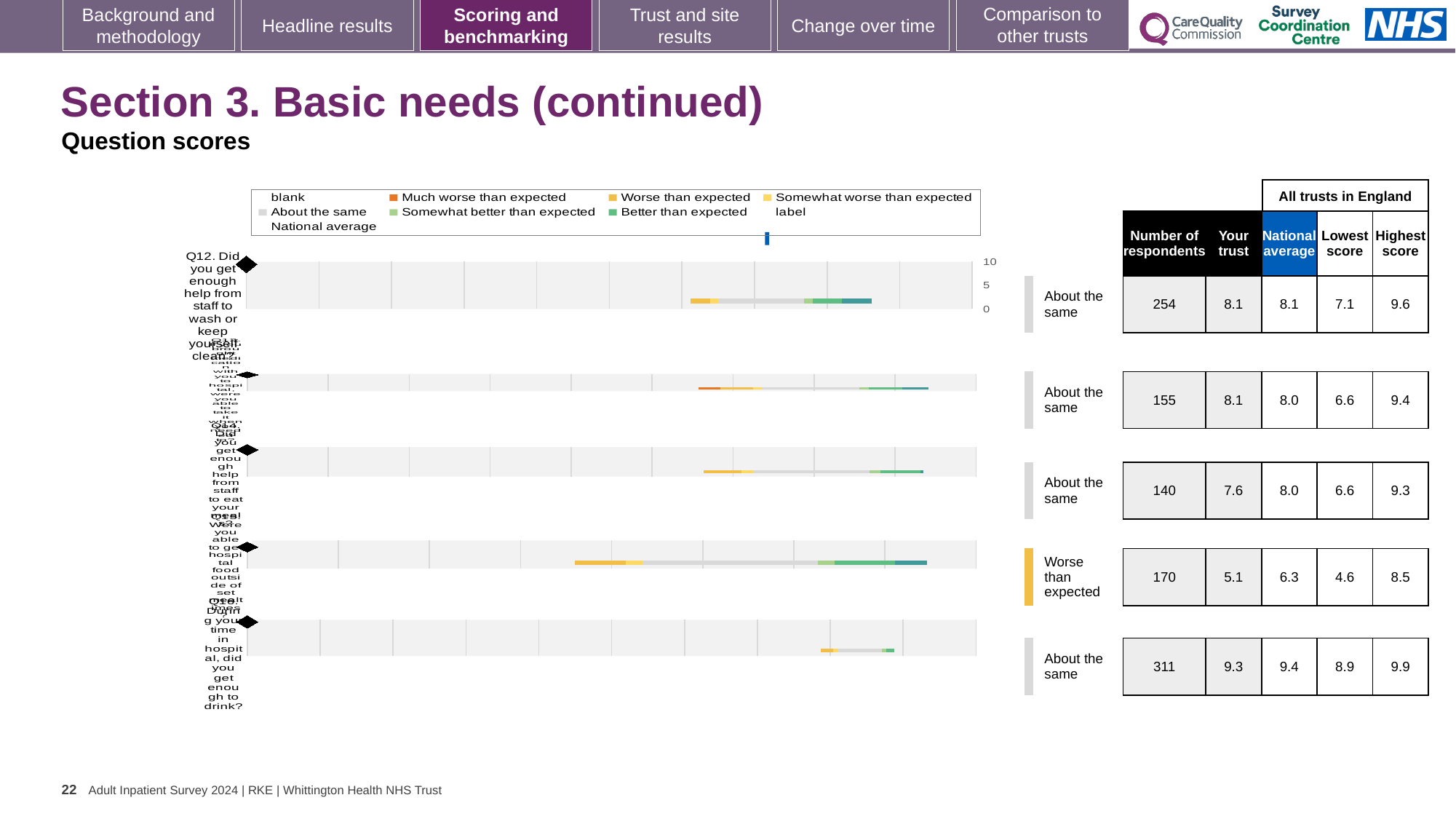
According to the table beside the chart, what is the 'Your trust' score for the first row (Q12, help from staff to wash or keep yourself clean)? 8.1 How many question rows are plotted in the chart? 5 What is the national average for the fourth row, the one rated 'Worse than expected'? 6.3 Which row has the highest 'Your trust' score? the fifth row (Q16, enough to drink), 9.3 Which row has the lowest 'Your trust' score? the fourth row (Q15), 5.1 According to the table beside the chart, how many respondents answered the first row question (Q12)? 254 For the fourth row (rated 'Worse than expected'), what is the difference between the national average and the 'Your trust' score? 1.2 Is the trust's score marker for the first row (Q12) greater or less than 5 on the axis? greater What is the 'Your trust' score for the fourth row, the one rated 'Worse than expected'? 5.1 For the third row (Q14, help from staff to eat your meals), which is larger: the 'Your trust' score or the national average? national average How many of the five rows are rated 'About the same'? 4 What kind of chart is used to show the question scores on this slide? bar chart